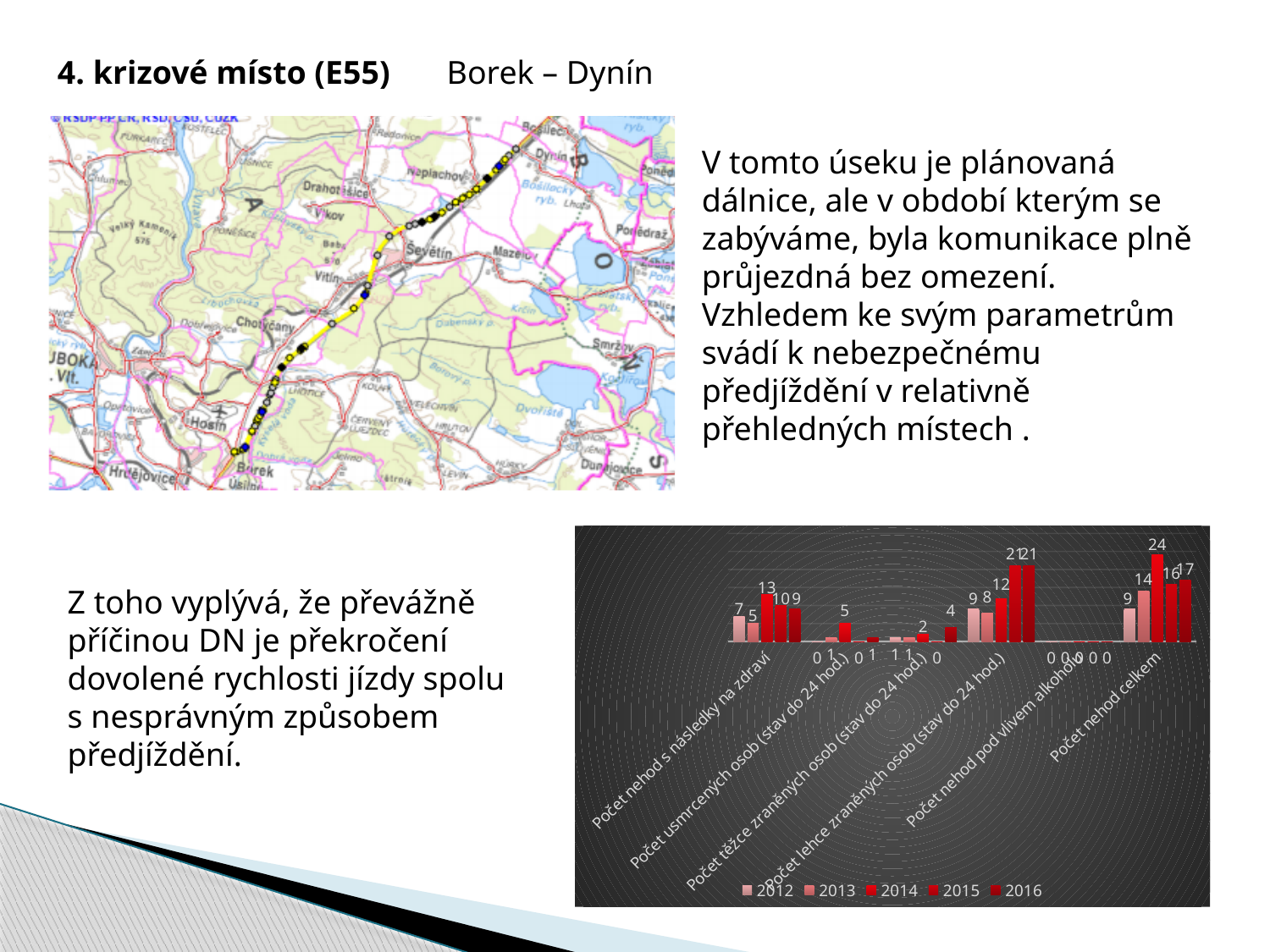
What is the difference between the 2014 and 2012 values in the category "Počet nehod celkem"? 15 What is the value for 2014 in the category "Počet nehod celkem"? 24 Which year has the highest value in the category "Počet nehod celkem"? 2014 What is the value for 2016 in the category "Počet nehod celkem"? 17 What is the value for 2012 in the category "Počet nehod celkem"? 9 What kind of chart is shown on the slide? bar chart What is the value for 2014 in the category "Počet nehod s následky na zdraví"? 13 Which year has the lowest value in the category "Počet nehod s následky na zdraví"? 2013 Which series is listed first in the chart legend? 2012 In the category "Počet nehod s následky na zdraví", which is larger: the value for 2012 or the value for 2013? 2012 How many categories are shown on the chart's x axis? 6 How many series does the chart legend list? 5